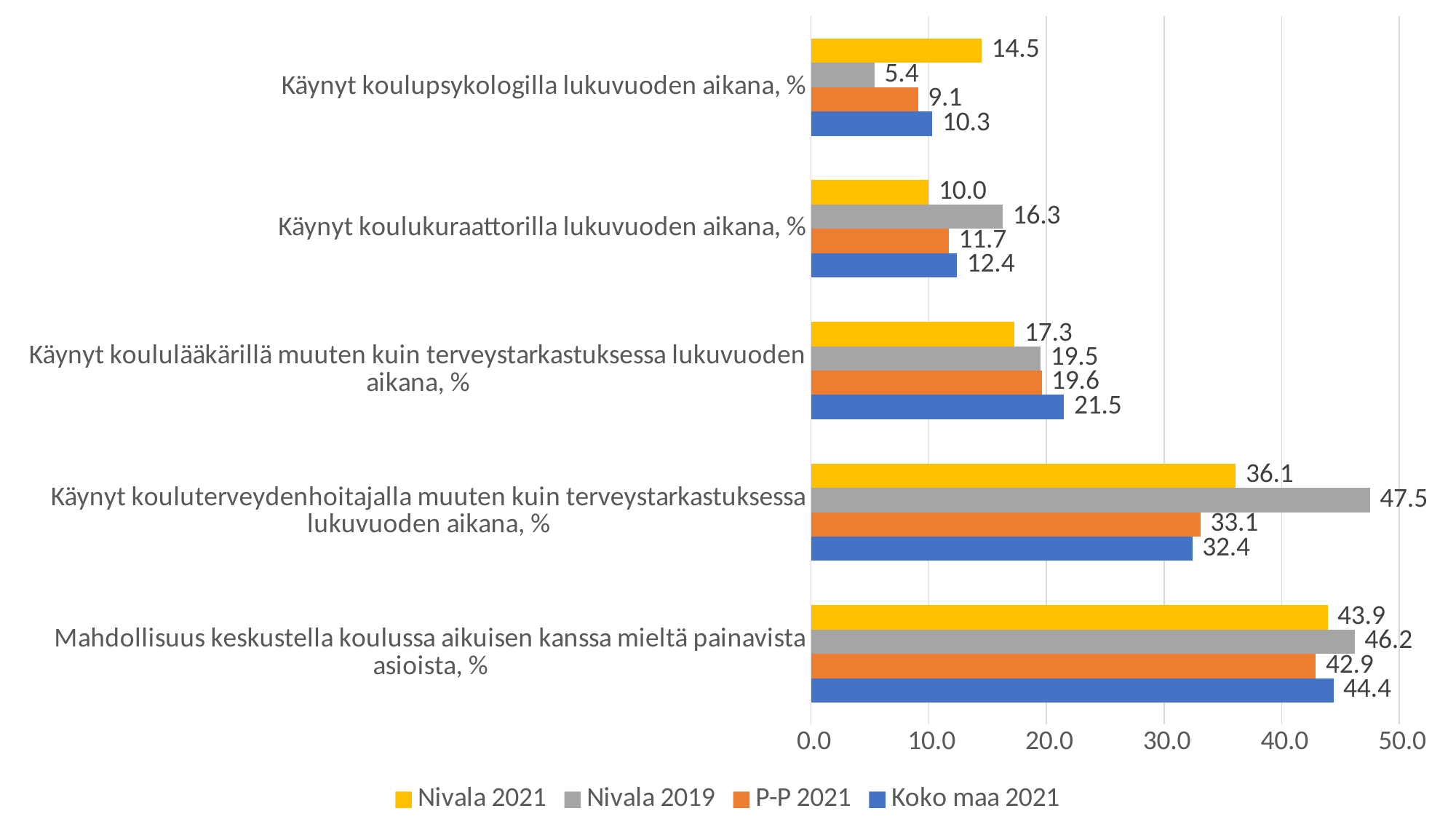
What is the Nivala 2019 value for "Käynyt koulukuraattorilla lukuvuoden aikana, %"? 16.3 What is the difference between the Nivala 2019 and Nivala 2021 values for "Käynyt kouluterveydenhoitajalla muuten kuin terveystarkastuksessa lukuvuoden aikana, %"? 11.4 Is the Nivala 2019 value for "Mahdollisuus keskustella koulussa aikuisen kanssa mieltä painavista asioista, %" greater or less than 40.0? greater How many series does the legend list? 4 What colour are the bars for the Nivala 2021 series? yellow For "Mahdollisuus keskustella koulussa aikuisen kanssa mieltä painavista asioista, %", which is larger: the P-P 2021 value or the Koko maa 2021 value? Koko maa 2021 Which series has the lowest value for "Käynyt koulupsykologilla lukuvuoden aikana, %"? Nivala 2019 How many categories are shown on the chart? 5 Which series has the highest value for "Käynyt kouluterveydenhoitajalla muuten kuin terveystarkastuksessa lukuvuoden aikana, %"? Nivala 2019 What kind of chart is shown on the slide? bar chart What is the Nivala 2021 value for "Käynyt koulupsykologilla lukuvuoden aikana, %"? 14.5 What is the Koko maa 2021 value for "Käynyt koululääkärillä muuten kuin terveystarkastuksessa lukuvuoden aikana, %"? 21.5